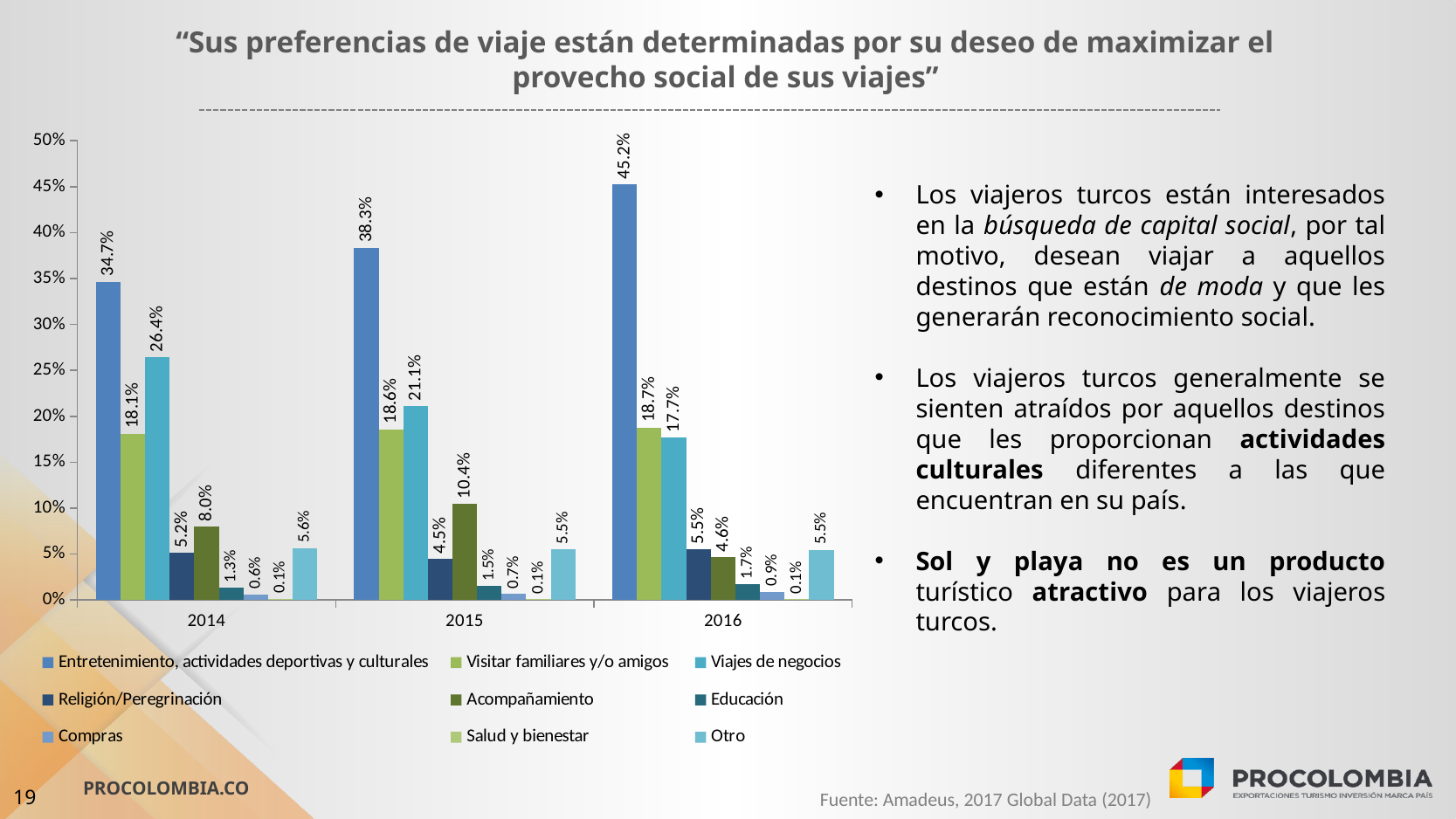
What is the value for Viajes de negocios in 2014? 26.4% Which series has the lowest value in 2014? Salud y bienestar Does the value for Viajes de negocios rise or fall from 2014 to 2016? Fall What is the difference between the Entretenimiento, actividades deportivas y culturales values for 2016 and 2014? 10.5% What kind of chart is shown on the slide? Bar chart Which is larger in 2016: Visitar familiares y/o amigos or Viajes de negocios? Visitar familiares y/o amigos Which series has the highest value in 2015? Entretenimiento, actividades deportivas y culturales What is the value for Acompañamiento in 2015? 10.4% What is the value for Entretenimiento, actividades deportivas y culturales in 2016? 45.2% What is the value for Religión/Peregrinación in 2016? 5.5% How many series does the legend list? 9 How many year categories are shown on the x axis? 3